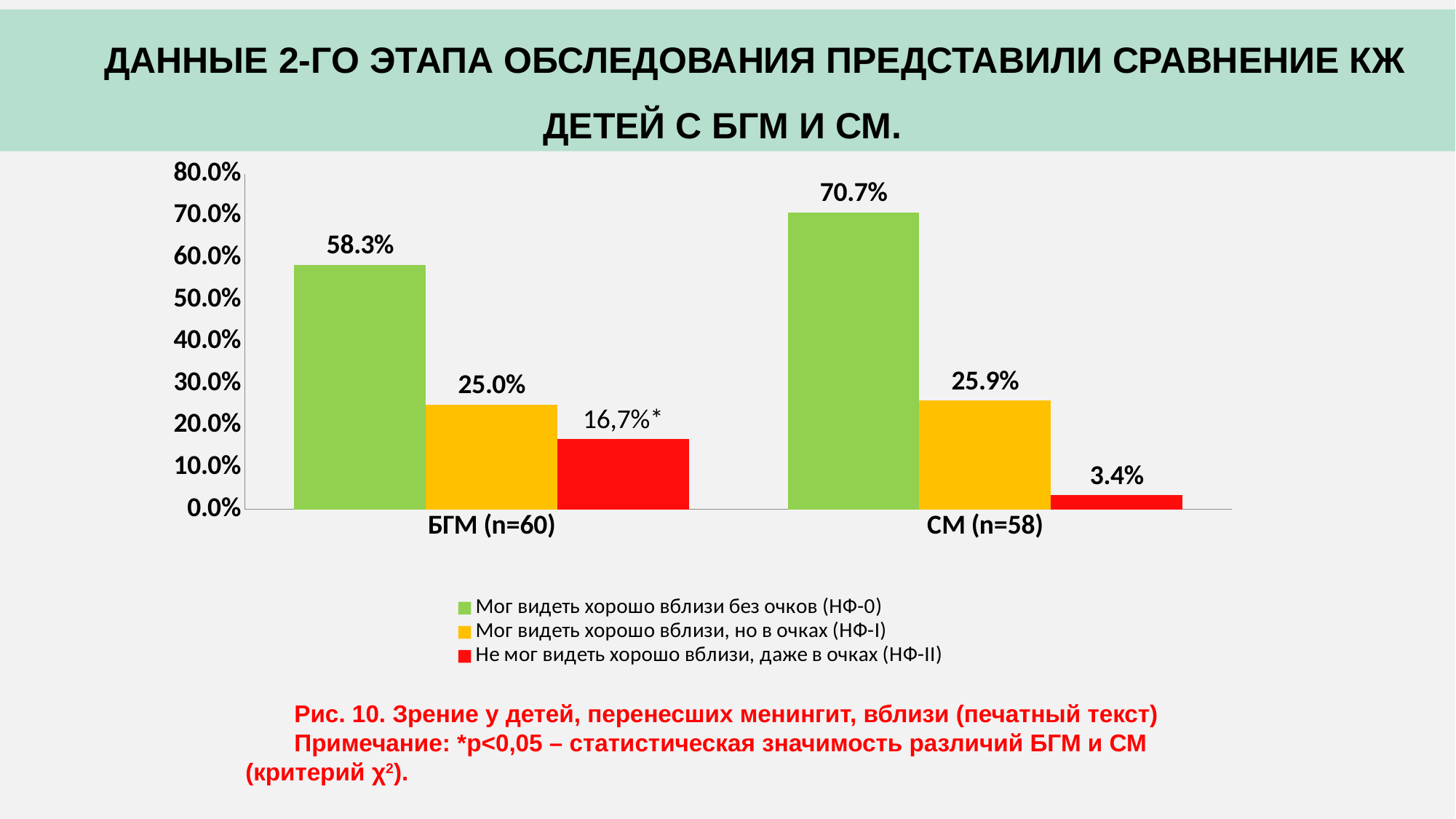
What is the value for 'Не мог видеть хорошо вблизи, даже в очках (НФ-II)' in the БГМ (n=60) group? 16,7% What is the value for 'Мог видеть хорошо вблизи без очков (НФ-0)' in the БГМ (n=60) group? 58.3% What is the value for 'Мог видеть хорошо вблизи без очков (НФ-0)' in the СМ (n=58) group? 70.7% What is the value for 'Мог видеть хорошо вблизи, но в очках (НФ-I)' in the СМ (n=58) group? 25.9% What is the difference between the СМ (n=58) and БГМ (n=60) values for 'Мог видеть хорошо вблизи без очков (НФ-0)'? 12.4% How many categories are shown on the x axis? 2 Which series has the lowest value in the СМ (n=58) group? Не мог видеть хорошо вблизи, даже в очках (НФ-II) What is the value for 'Не мог видеть хорошо вблизи, даже в очках (НФ-II)' in the СМ (n=58) group? 3.4% Which group has the higher value for 'Мог видеть хорошо вблизи без очков (НФ-0)'? СМ (n=58) What kind of chart is shown on the slide? bar chart What colour represents 'Мог видеть хорошо вблизи, но в очках (НФ-I)' in the chart? yellow How many series does the legend list? 3